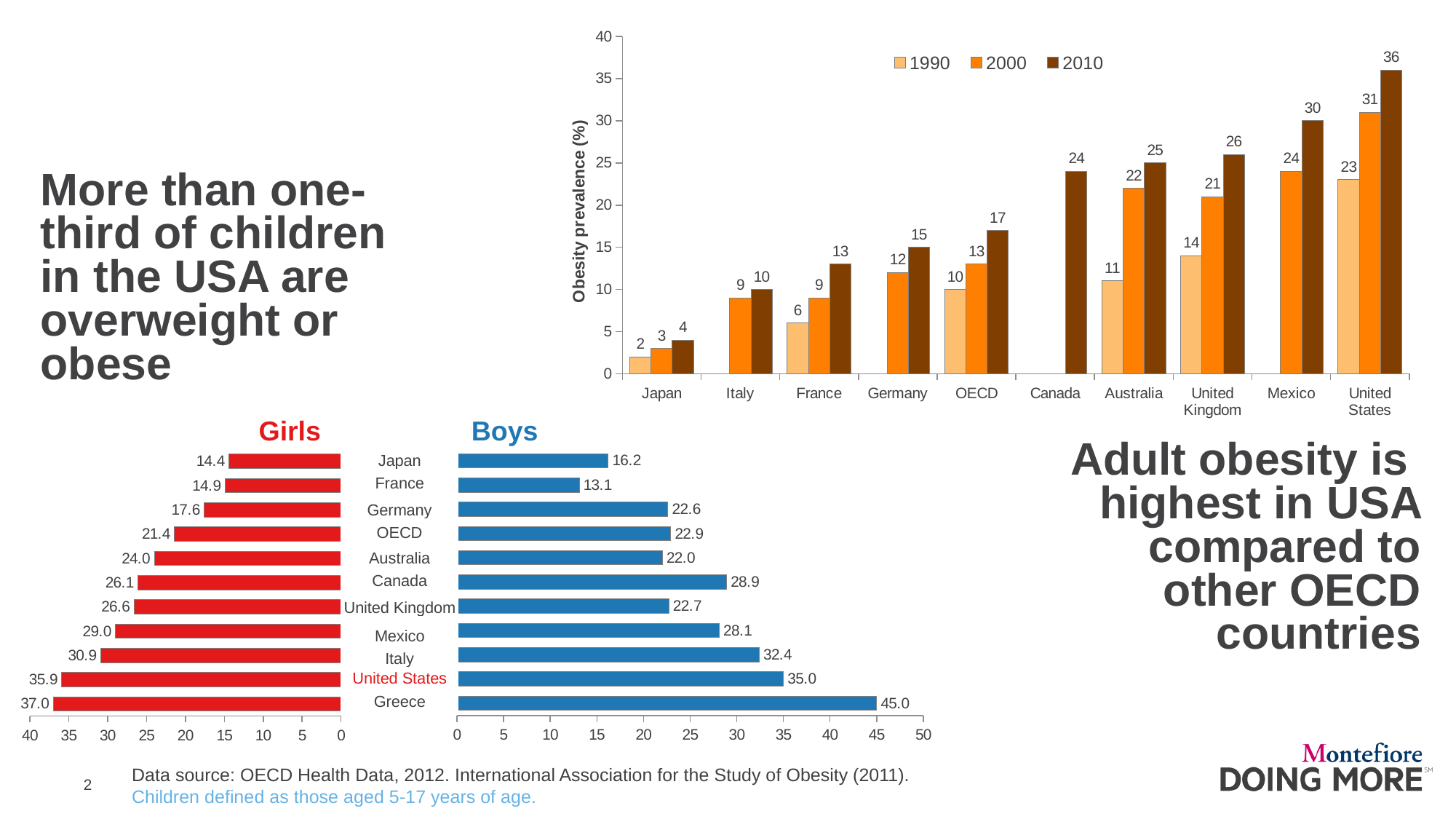
In the adult obesity prevalence chart at the top right, what is the value for the United States in 2010? 36 In the adult obesity prevalence chart at the top right, what is the difference between the 2010 and 1990 values for Australia? 14 In the Girls/Boys children chart at the bottom left, what is the value for Boys in Canada? 28.9 In the adult obesity prevalence chart at the top right, which is larger in 2000: Mexico or the United Kingdom? Mexico In the Girls/Boys children chart at the bottom left, what is the value for Girls in the United States? 35.9 In the adult obesity prevalence chart at the top right, which country has the lowest value in 2010? Japan In the adult obesity prevalence chart at the top right, how many series does the legend list? 3 In the adult obesity prevalence chart at the top right, what is the value for France in 1990? 6 In the Girls/Boys children chart at the bottom left, which country has the highest value for Boys? Greece In the adult obesity prevalence chart at the top right, how many countries or groups are shown on the x axis? 10 What kind of chart is the Girls/Boys children chart at the bottom left? Bar chart In the Girls/Boys children chart at the bottom left, which country has the lowest value for Girls? Japan